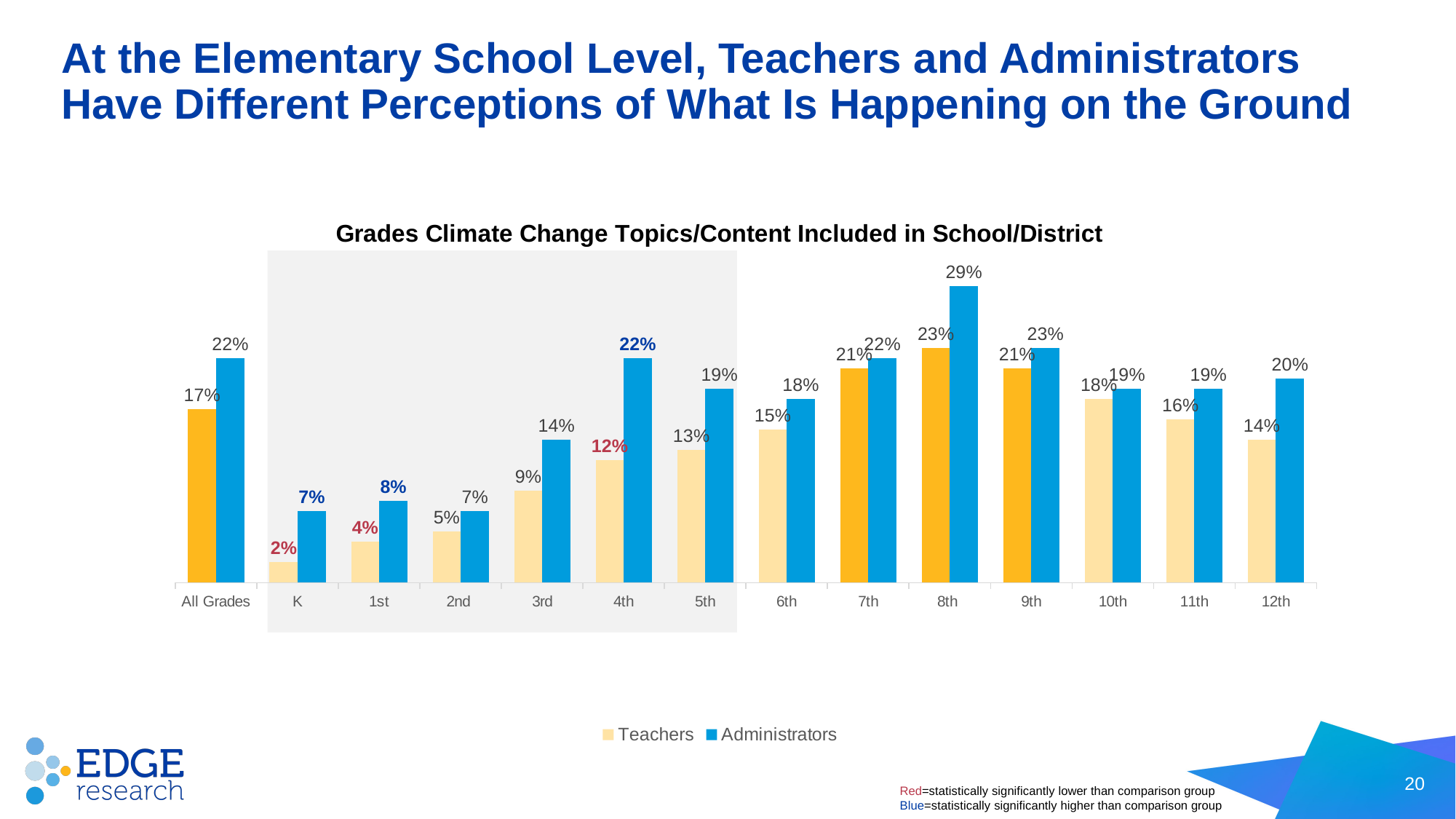
What kind of chart is shown on the slide? Bar chart What is the Administrators value for 8th grade? 29% What percentage of Teachers reported climate change topics included for All Grades? 17% Which grade has the highest Administrators value? 8th What is the title of the chart? Grades Climate Change Topics/Content Included in School/District How many series does the legend list? 2 Which is larger for 12th grade, the Teachers value or the Administrators value? Administrators How many grade categories are shown on the x axis, including All Grades? 15 Which grade has the lowest Teachers value? K What is the Teachers value for K (kindergarten)? 2% What is the Administrators value for 4th grade? 22% What is the difference between the Administrators and Teachers values for 4th grade? 10%